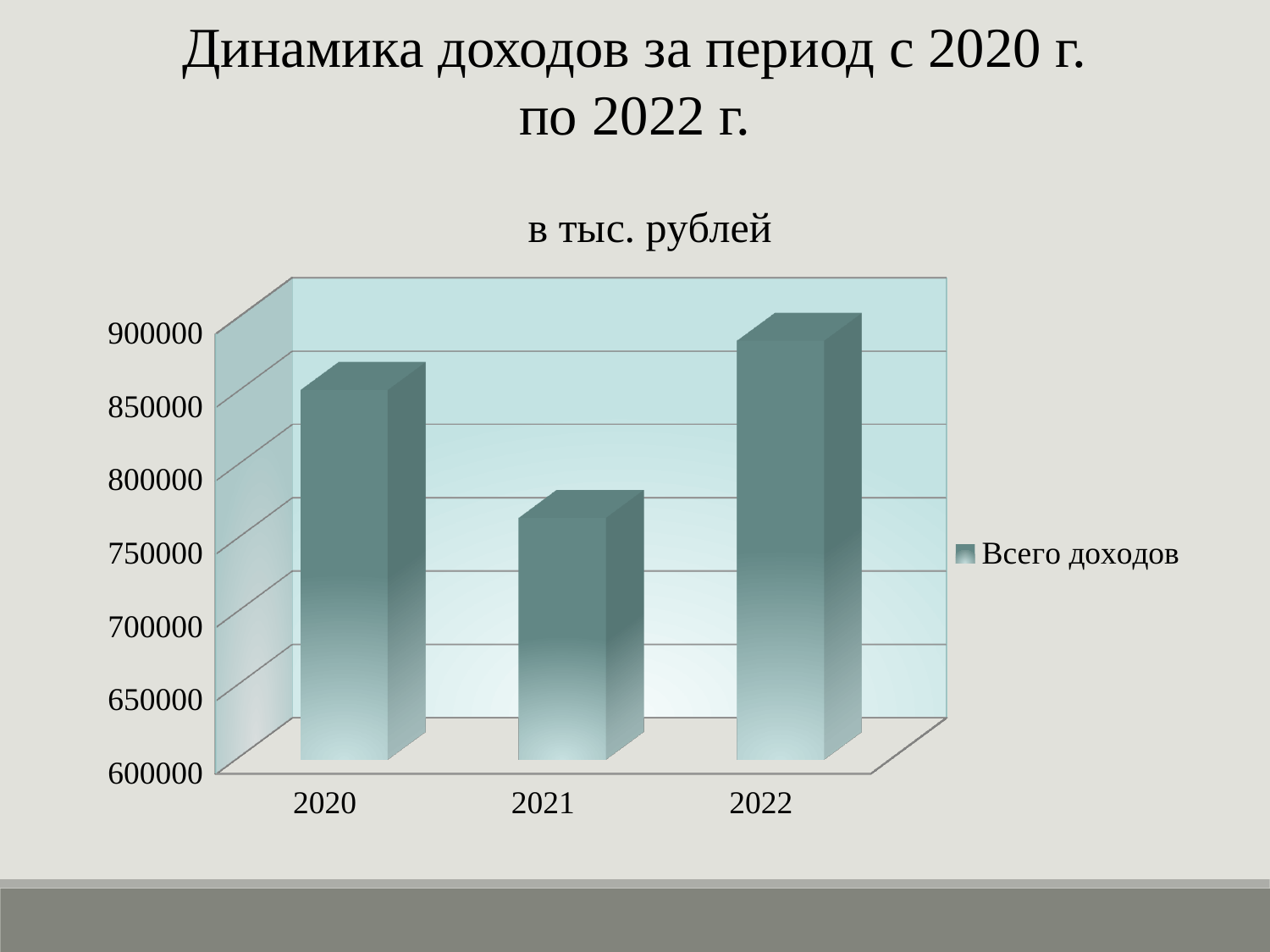
How many series does the chart's legend list? 1 Which year has the highest value in the chart? 2022 What is the name of the series listed in the chart's legend? Всего доходов Is the value for 2021 greater or less than 800000? less Which is larger, the value for 2020 or the value for 2021? 2020 Which year has the lowest value in the chart? 2021 Is the value for 2020 greater or less than 800000? greater Is the value for 2022 greater or less than 850000? greater Which is larger, the value for 2020 or the value for 2022? 2022 What kind of chart is shown on the slide? bar chart Does the value rise or fall from 2021 to 2022? rise How many years (categories) are shown on the x axis of the chart? 3